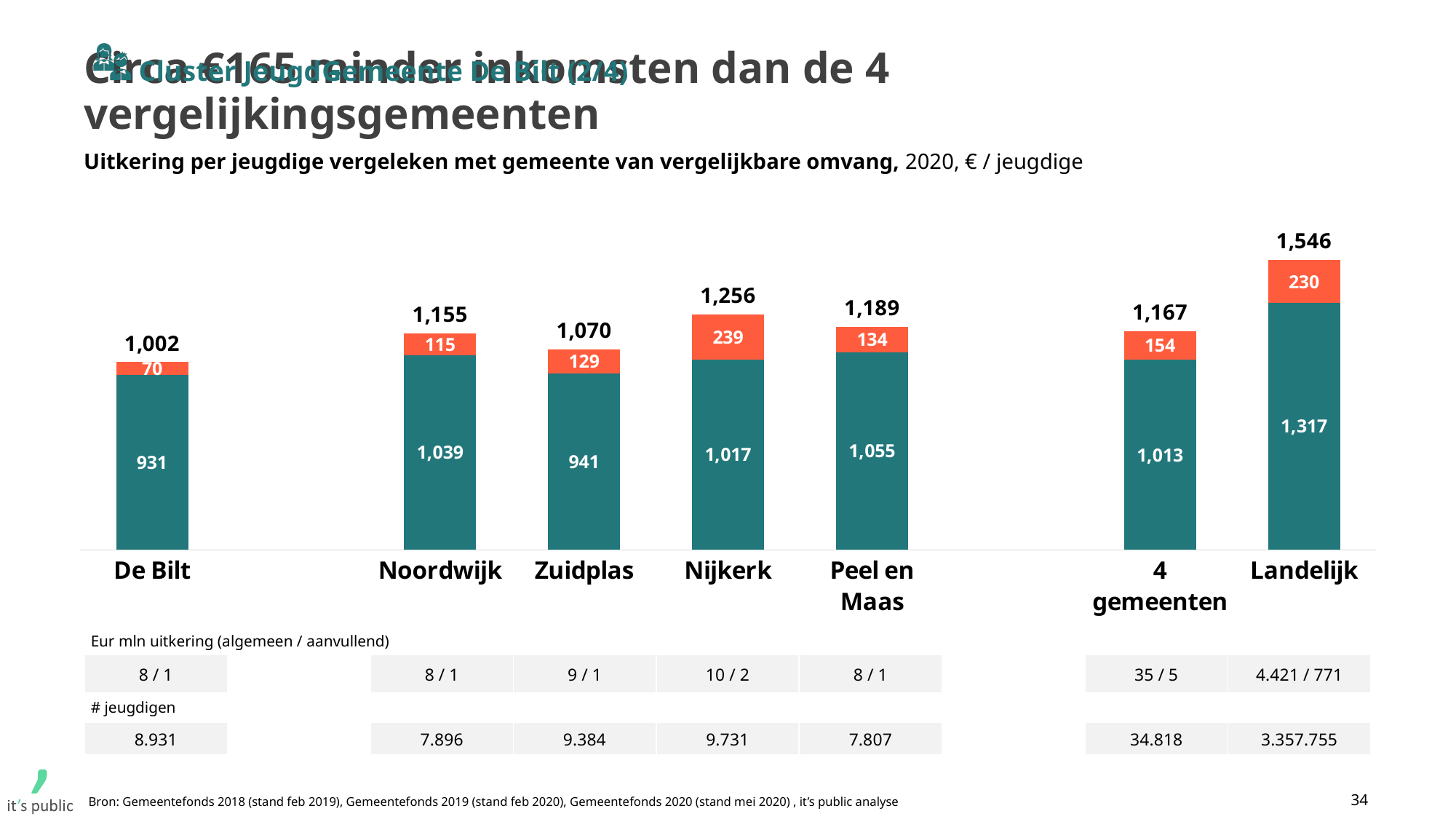
What is the value of the orange (top) segment for Nijkerk? 239 Which category has the lowest total value? De Bilt How many bars are shown in the chart? 7 What is the value of the teal (bottom) segment for Landelijk? 1,317 What unit is stated in the chart subtitle for the values? € / jeugdige Which category has the highest total value? Landelijk What is the total value shown above the bar for De Bilt? 1,002 Which has a larger total value, Nijkerk or Peel en Maas? Nijkerk What is the difference between the total for 4 gemeenten and the total for De Bilt? 165 What is the value of the teal (bottom) segment for Peel en Maas? 1,055 What kind of chart is shown on the slide? Stacked bar chart What is the sum of the two segments of the Zuidplas bar? 1,070